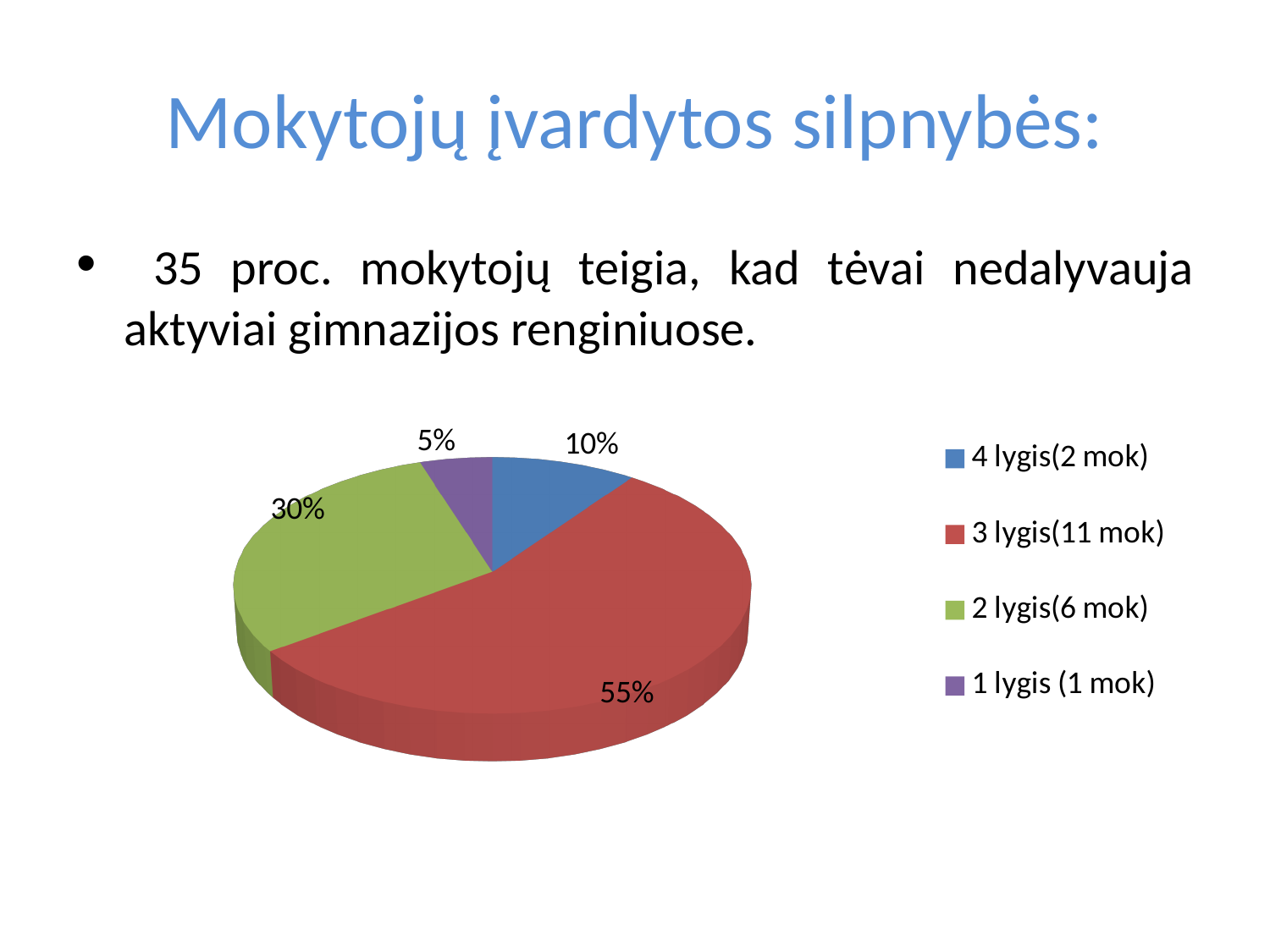
What kind of chart is shown on the slide? pie chart Which slice is larger, "4 lygis(2 mok)" or "2 lygis(6 mok)"? 2 lygis(6 mok) What share of the pie does "3 lygis(11 mok)" have? 55% What share of the pie does "2 lygis(6 mok)" have? 30% What share of the pie does "1 lygis (1 mok)" have? 5% What is the title of the slide containing the chart? Mokytojų įvardytos silpnybės: How many categories does the pie chart have? 4 Which category has the smallest slice of the pie? 1 lygis (1 mok) Which category has the largest slice of the pie? 3 lygis(11 mok) What colour is the "3 lygis(11 mok)" slice? red What is the difference in percentage points between the "3 lygis(11 mok)" slice and the "2 lygis(6 mok)" slice? 25 percentage points